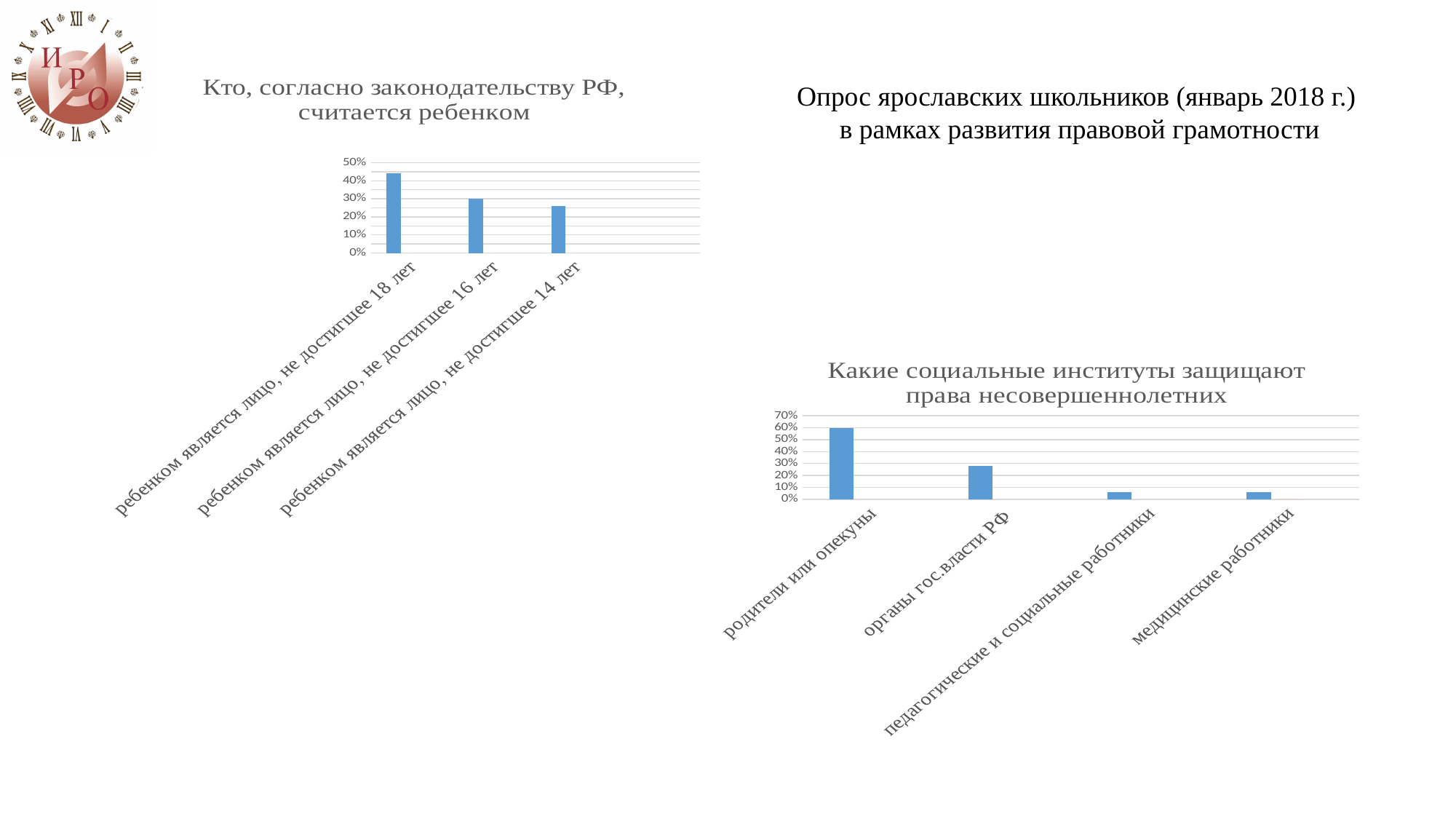
How many categories are shown in the chart titled "Кто, согласно законодательству РФ, считается ребенком"? 3 In the chart titled "Какие социальные институты защищают права несовершеннолетних", is the value for "педагогические и социальные работники" greater or less than 10%? less In the chart titled "Какие социальные институты защищают права несовершеннолетних", which is larger: the value for "органы гос.власти РФ" or the value for "медицинские работники"? органы гос.власти РФ In the chart titled "Кто, согласно законодательству РФ, считается ребенком", is the value for "ребенком является лицо, не достигшее 14 лет" greater or less than 30%? less In the chart titled "Какие социальные институты защищают права несовершеннолетних", which category has the highest value? родители или опекуны In the chart titled "Какие социальные институты защищают права несовершеннолетних", is the value for "родители или опекуны" greater or less than 50%? greater In the chart titled "Кто, согласно законодательству РФ, считается ребенком", which category has the lowest value? ребенком является лицо, не достигшее 14 лет In the chart titled "Кто, согласно законодательству РФ, считается ребенком", which category has the highest value? ребенком является лицо, не достигшее 18 лет How many categories are shown in the chart titled "Какие социальные институты защищают права несовершеннолетних"? 4 What kind of chart is the chart titled "Кто, согласно законодательству РФ, считается ребенком"? bar chart In the chart titled "Кто, согласно законодательству РФ, считается ребенком", do the values rise or fall from left to right? fall